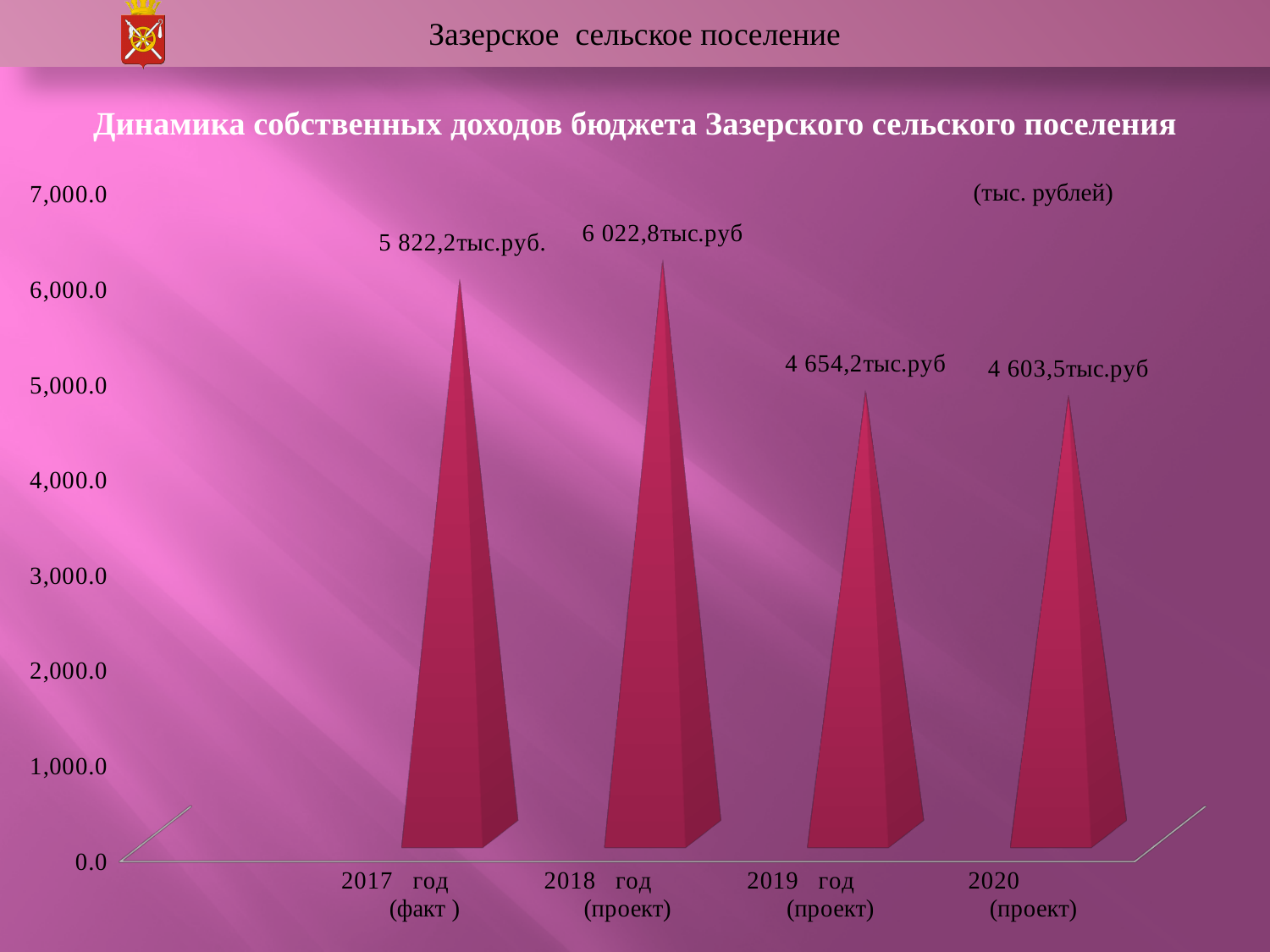
What is the title of the chart? Динамика собственных доходов бюджета Зазерского сельского поселения What is the difference between the values for 2018 год (проект) and 2017 год (факт)? 200,6 тыс.руб What is the value for 2018 год (проект)? 6 022,8тыс.руб What is the value for 2017 год (факт)? 5 822,2тыс.руб. Which is larger, the value for 2019 год (проект) or for 2020 (проект)? 2019 год (проект) What is the value for 2019 год (проект)? 4 654,2тыс.руб Which year has the lowest value? 2020 (проект) How many years are shown on the chart? 4 What is the difference between the values for 2018 год (проект) and 2020 (проект)? 1 419,3 тыс.руб Which year has the highest value? 2018 год (проект) What is the value for 2020 (проект)? 4 603,5тыс.руб Is the value for 2017 год (факт) greater or less than 5,000.0? greater